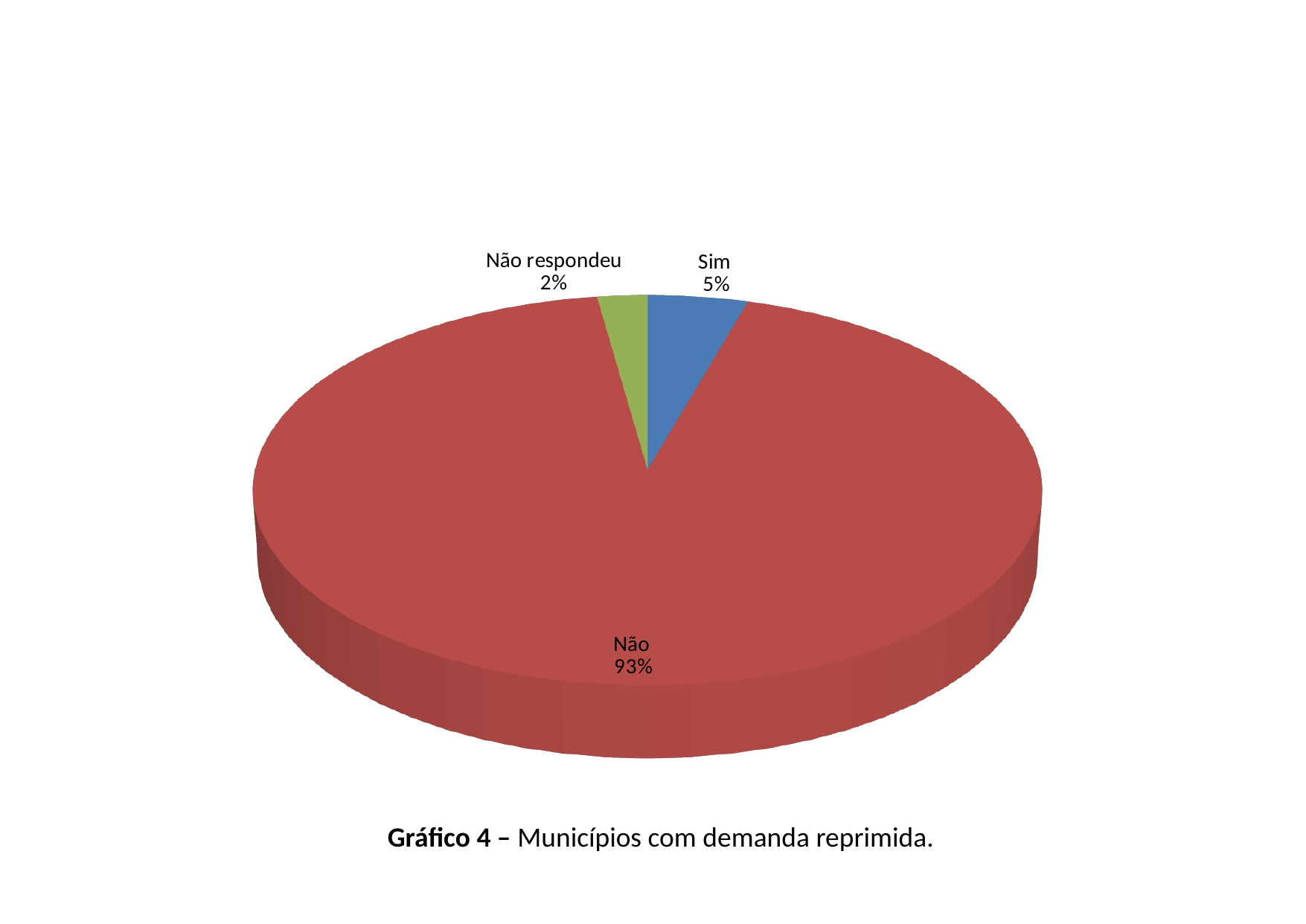
What kind of chart is shown on the slide? pie chart What is the difference in percentage points between the "Não" and "Sim" slices? 88 What is the difference in percentage points between the "Sim" and "Não respondeu" slices? 3 What is the caption of the chart? Gráfico 4 – Municípios com demanda reprimida. What share of the pie does the "Sim" slice represent? 5% What share of the pie does the "Não" slice represent? 93% What colour is the "Não" slice? red What share of the pie does the "Não respondeu" slice represent? 2% Which category has the largest slice of the pie? Não Which category has the smallest slice of the pie? Não respondeu Which slice is larger, "Sim" or "Não respondeu"? Sim How many slices does the pie chart have? 3